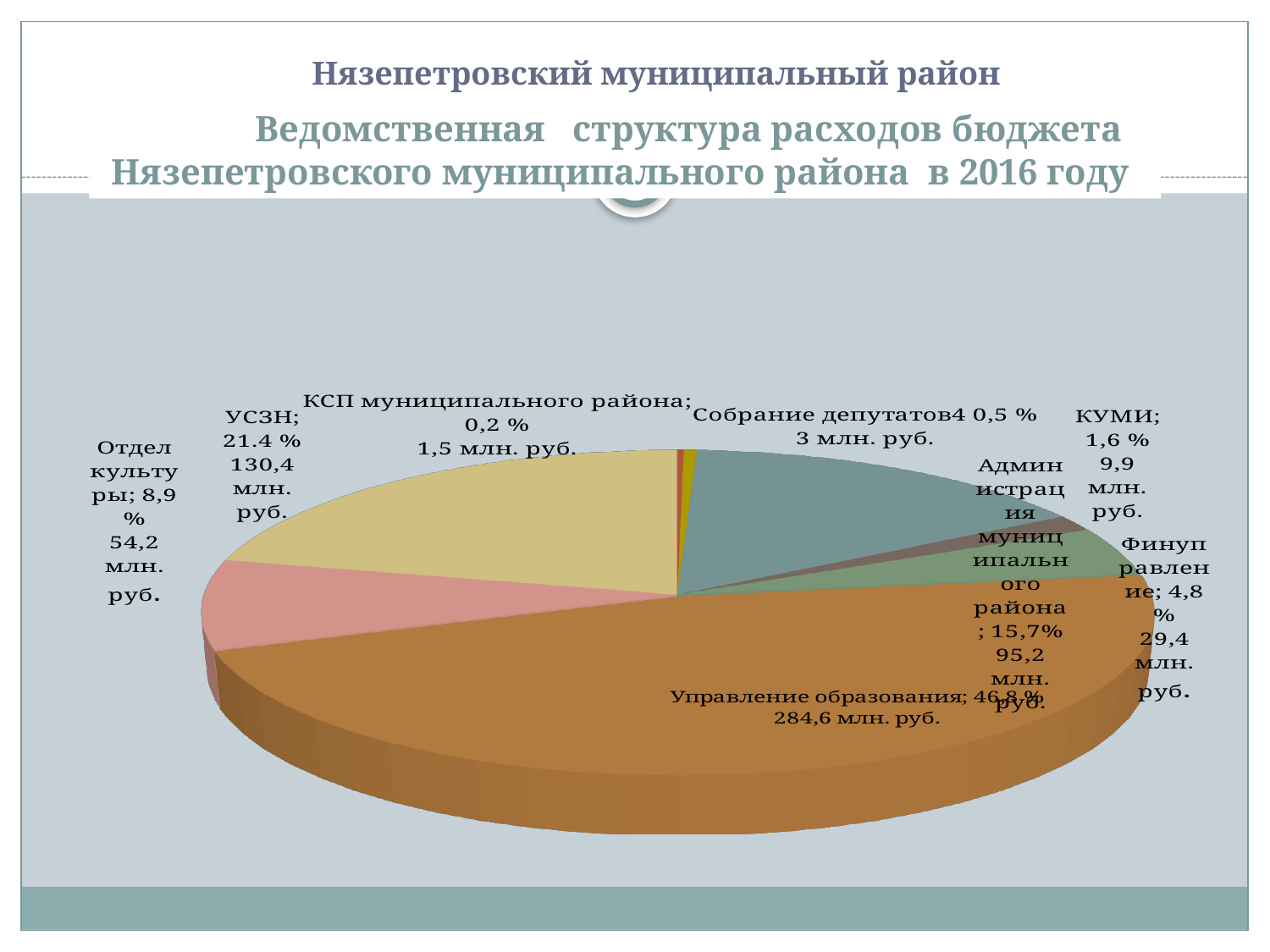
What year does the chart title say the budget expenditure structure refers to? 2016 What is the amount in млн. руб. for Финуправление? 29,4 млн. руб. What is the amount in млн. руб. for Управление образования? 284,6 млн. руб. What type of chart is shown on the slide? Pie chart What percentage share is shown for Администрация муниципального района? 15,7% Which is larger, the amount for Отдел культуры or the amount for КУМИ? Отдел культуры How many categories (slices) does the pie chart show? 8 Which category has the smallest share of the pie? КСП муниципального района What is the amount in млн. руб. for УСЗН? 130,4 млн. руб. Which category has the largest share of the pie? Управление образования What is the difference in млн. руб. between Управление образования and УСЗН? 154,2 млн. руб. What share of the budget expenditure does Управление образования account for? 46,8 %